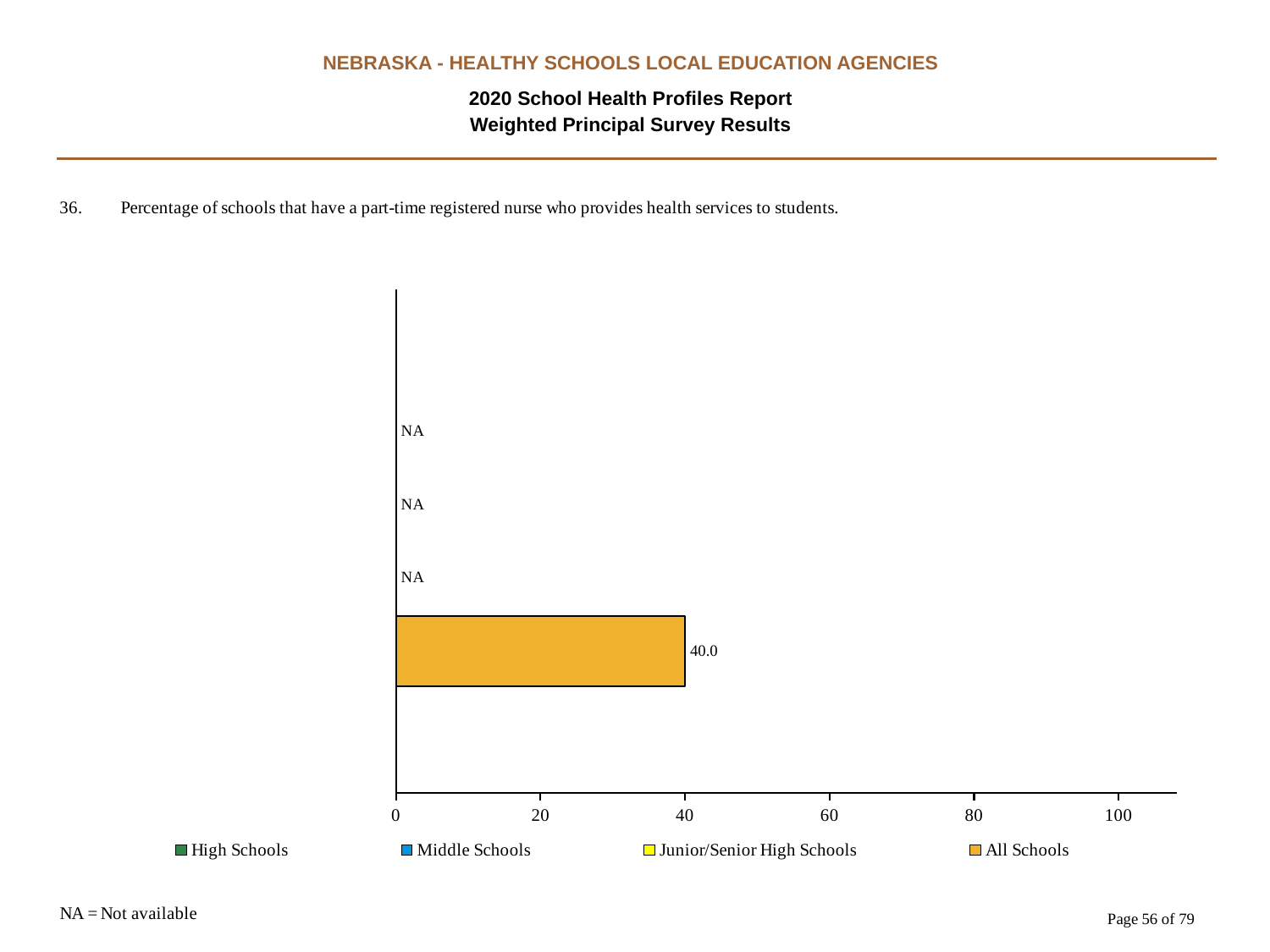
How many series does the legend list? 4 What is shown for Middle Schools? NA What is shown for Junior/Senior High Schools? NA What does NA stand for according to the note on the slide? Not available What is the value for All Schools? 40.0 What is the highest value shown on the x axis? 100 Which series has the only plotted bar? All Schools What is shown for High Schools? NA What kind of chart is this? Bar chart How many series have a plotted bar with a numeric value? 1 Is the value for All Schools greater or less than 60? less Is the value for All Schools greater or less than 20? greater